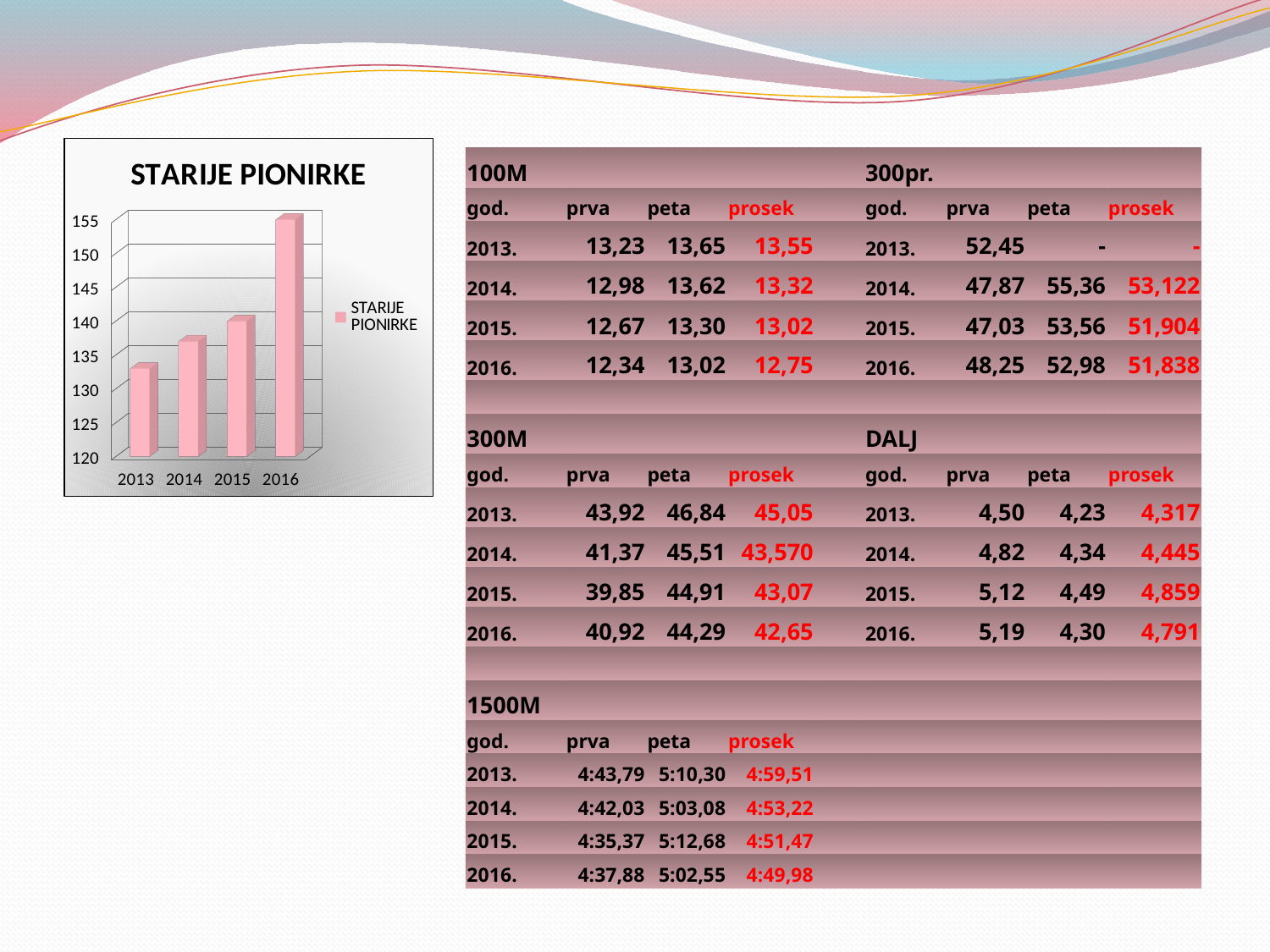
Do the bar values rise or fall from 2013 to 2016? rise Which year has the highest bar in the chart? 2016 How many series does the chart's legend list? 1 What kind of chart is shown on the slide? bar chart How many years are shown on the x axis of the chart? 4 Is the value for 2013 greater or less than 130? greater What is the title of the chart? STARIJE PIONIRKE Which year has the lowest bar in the chart? 2013 Is the value for 2016 greater or less than 150? greater Is the value for 2015 greater or less than 145? less Which is larger, the value for 2014 or the value for 2016? 2016